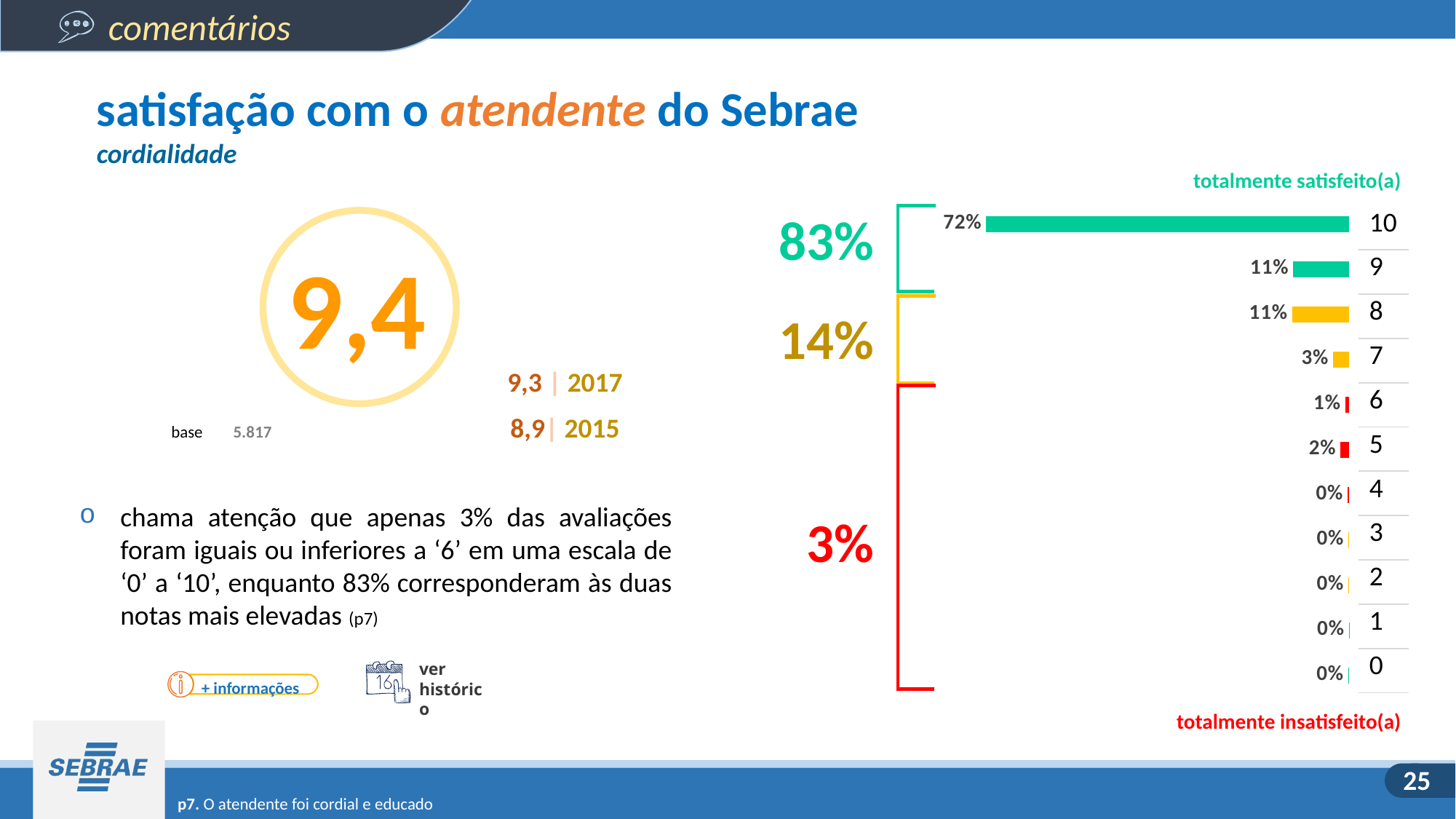
What percentage of evaluations gave a score of 10? 72% Which has a larger percentage, score 6 or score 5? 5 What kind of chart is used to show the distribution of scores? bar chart What percentage of evaluations gave a score of 9? 11% What is the difference in percentage points between score 10 and score 9? 61 What percentage of evaluations gave a score of 5? 2% Which score has the highest percentage of evaluations? 10 How many score categories are shown on the chart? 11 What is the combined percentage shown for scores 9 and 10? 83% What percentage of evaluations gave a score of 7? 3% What label appears at the top of the chart above score 10? totalmente satisfeito(a) What is the combined percentage shown for scores 7 and 8? 14%